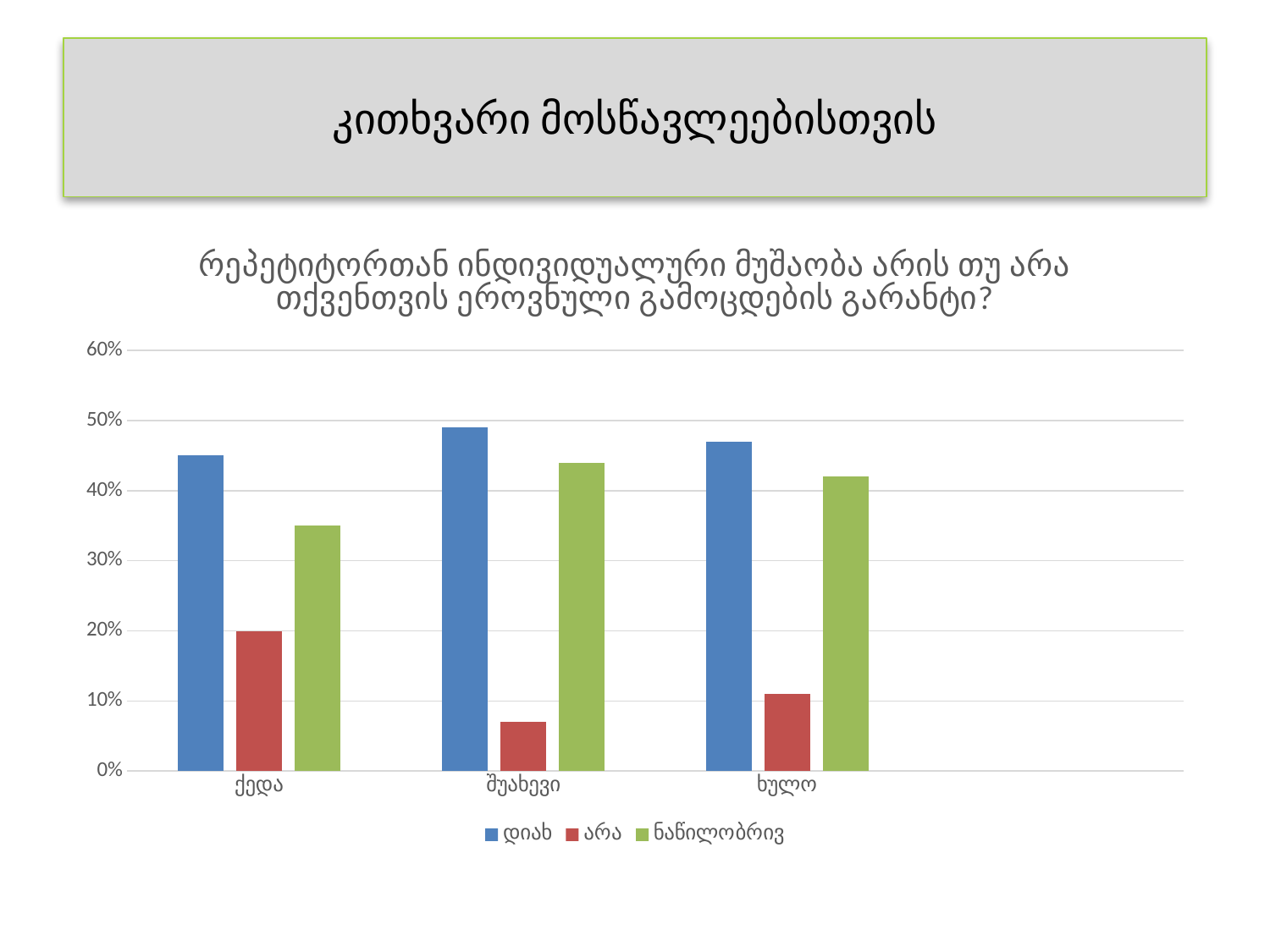
Which series is shown in blue in the legend? დიახ Is the value for არა in ხულო greater or less than 20%? less Is the value for დიახ in შუახევი greater or less than 40%? greater In ქედა, which is larger: the value for დიახ or the value for ნაწილობრივ? დიახ Is the value for ნაწილობრივ in ქედა greater or less than 40%? less What kind of chart is shown on the slide? bar chart How many categories are shown on the x axis of the chart? 3 Which series is shown in green in the legend? ნაწილობრივ Which category has the lowest value for არა? შუახევი How many series does the legend list? 3 Which category has the highest value for არა? ქედა